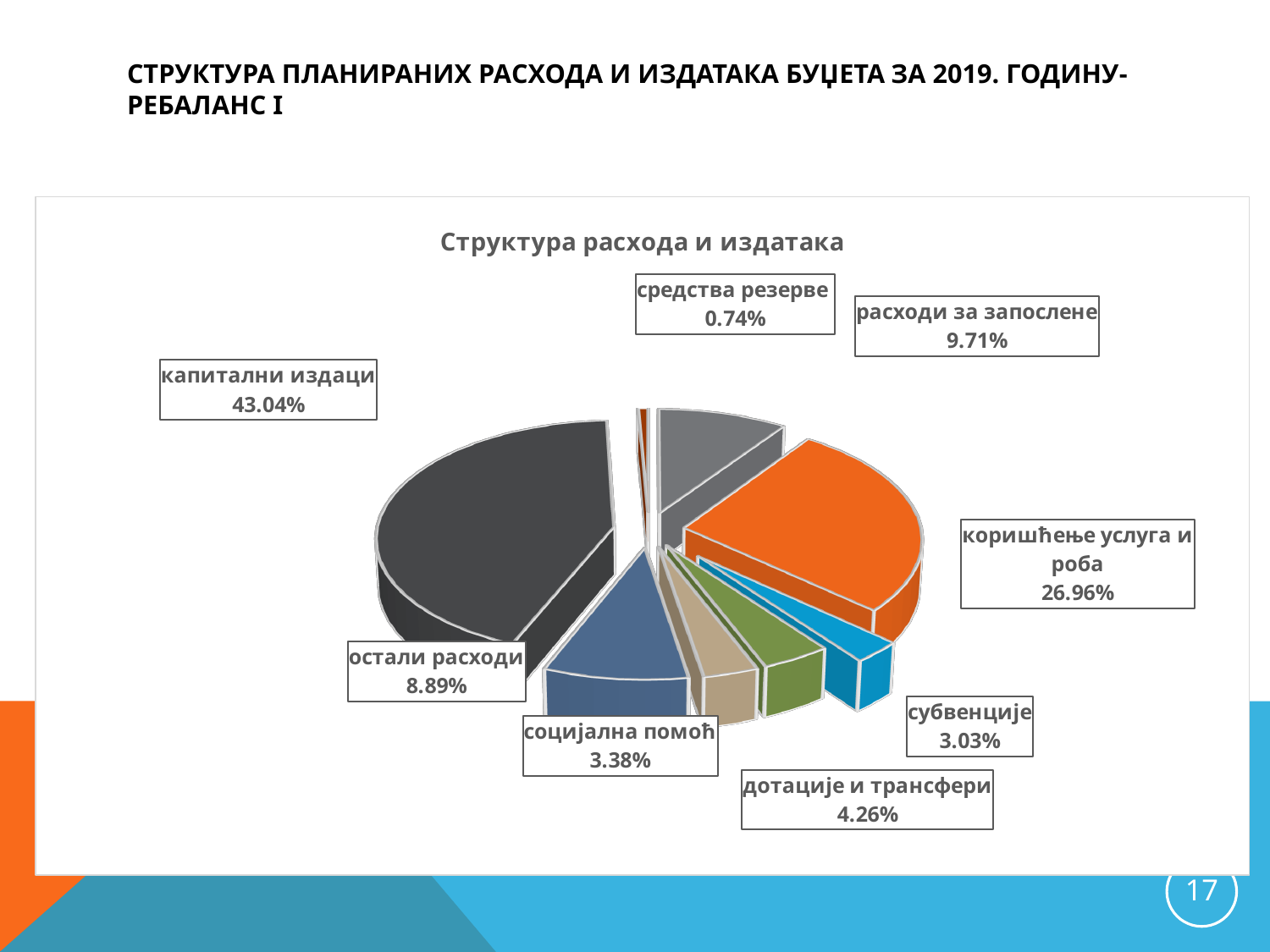
What kind of chart is shown on the slide? pie chart Which category has the largest share of the pie? капитални издаци What share of the pie is капитални издаци? 43.04% Which is larger, the share for расходи за запослене or the share for остали расходи? расходи за запослене How many slices does the pie chart have? 8 What is the difference between the shares for капитални издаци and коришћење услуга и роба? 16.08% What share of the pie is дотације и трансфери? 4.26% What is the title of the chart? Структура расхода и издатака Which category has the smallest share of the pie? средства резерве What share of the pie is коришћење услуга и роба? 26.96% What is the difference between the shares for дотације и трансфери and субвенције? 1.23% What share of the pie is средства резерве? 0.74%